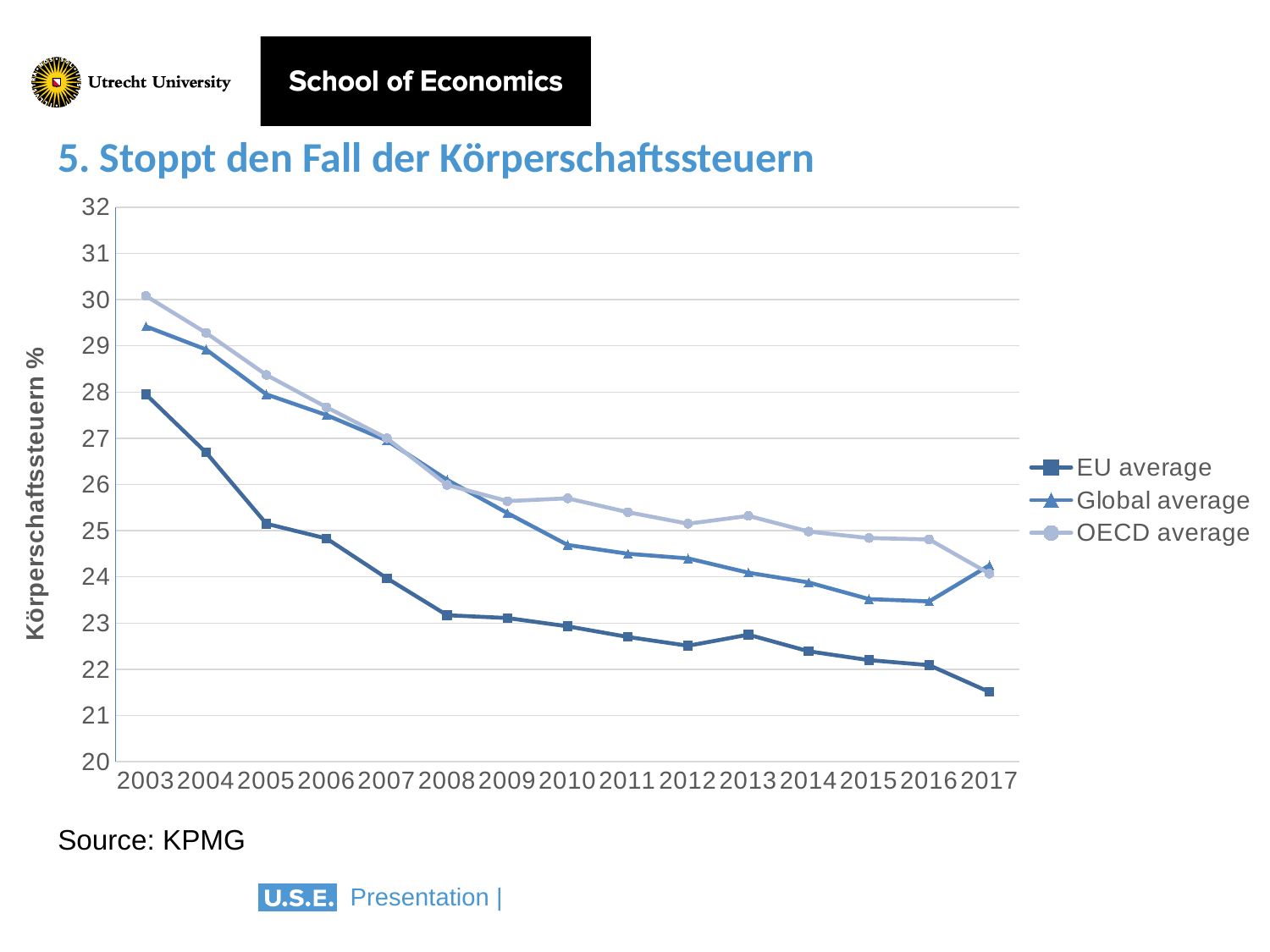
Which series has the highest value in 2003? OECD average How many years are plotted along the x axis? 15 Does the EU average rise or fall from 2003 to 2017? fall Is the value for EU average in 2017 greater or less than 22? less What kind of chart is shown on the slide? line chart Which series has the lowest value in 2017? EU average What is the label on the y axis? Körperschaftssteuern % Is the value for EU average in 2003 greater or less than 27? greater Which is larger in 2010, the EU average or the OECD average? OECD average Is the value for OECD average in 2003 greater or less than 29? greater How many series does the legend list? 3